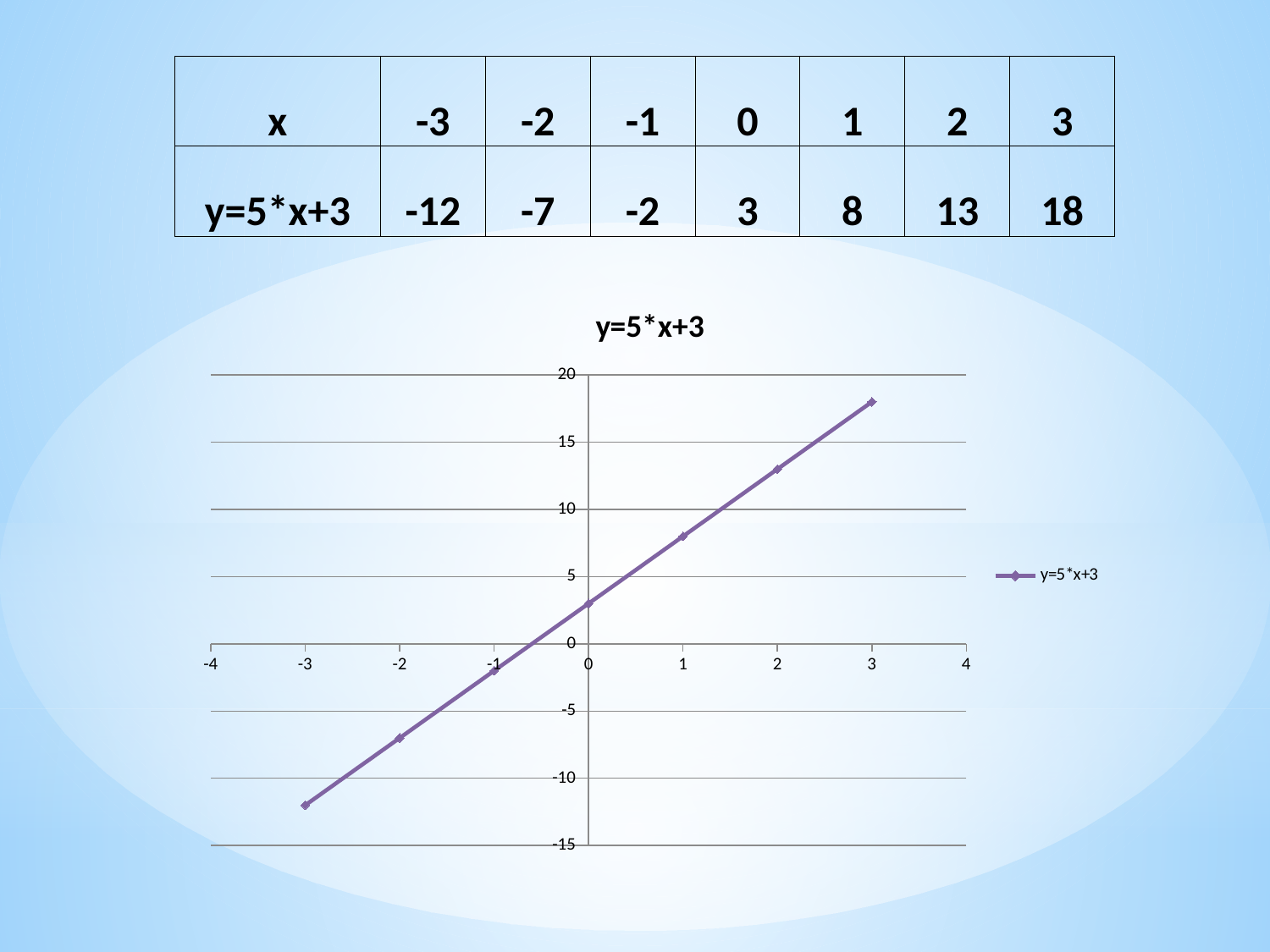
What is the value of y=5*x+3 at x = -3? -12 Do the values rise or fall as x increases along the x axis? rise At which x value is y=5*x+3 lowest? -3 How many data points are plotted on the chart? 7 How many series does the chart legend list? 1 What is the value of y=5*x+3 at x = 0? 3 Which is larger, the value at x = 1 or the value at x = -1? x = 1 What kind of chart is shown on the slide? line chart At which x value is y=5*x+3 highest? 3 What is the difference between the value at x = 3 and the value at x = -3? 30 What is the title of the chart? y=5*x+3 What is the value of y=5*x+3 at x = 3? 18